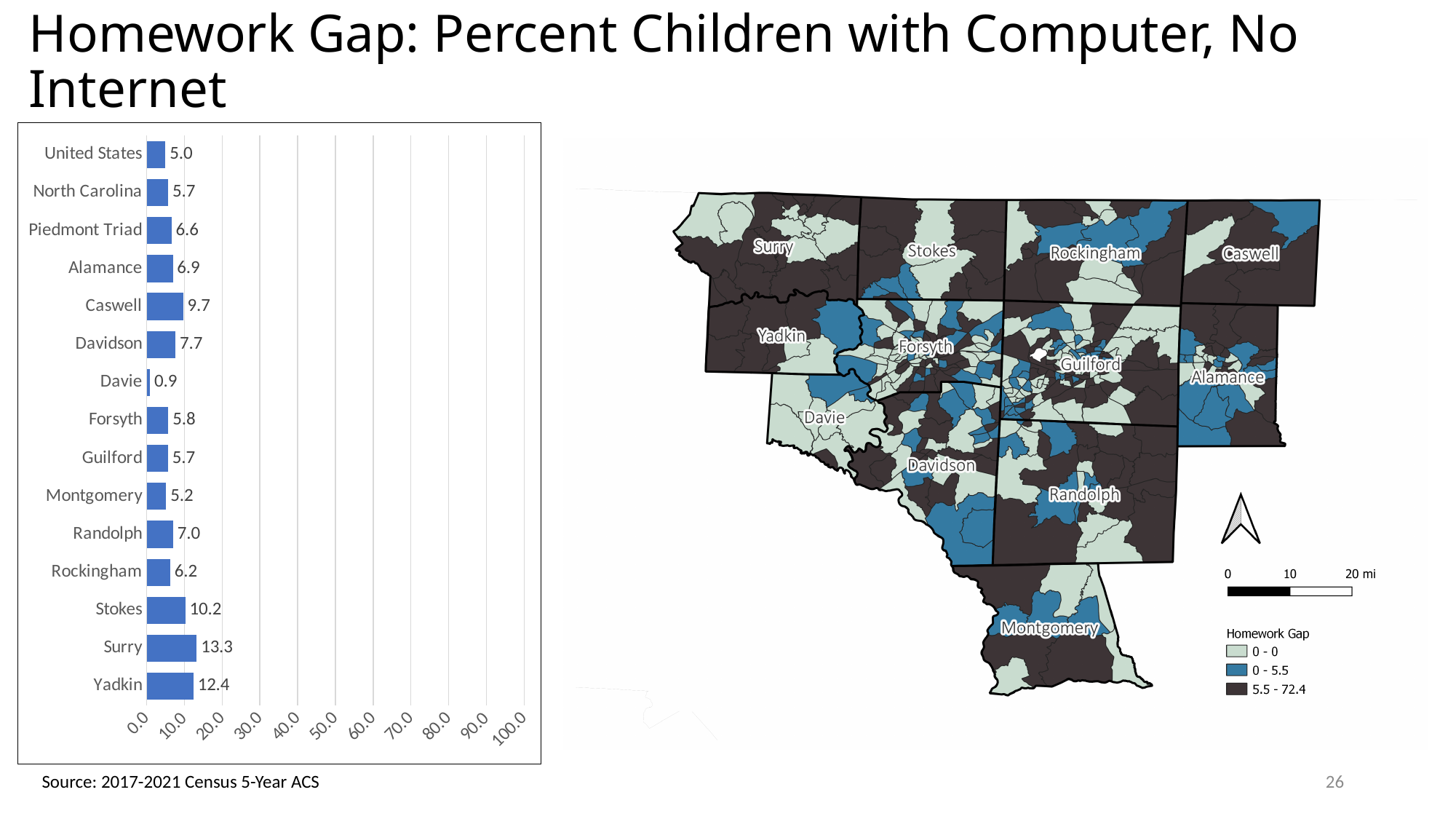
Which is larger in the bar chart, the value for Caswell or the value for Davidson? Caswell What is the difference between the values for North Carolina and the United States in the bar chart? 0.7 Which category has the lowest value in the bar chart? Davie What is the value for Surry in the bar chart? 13.3 What is the value for Piedmont Triad in the bar chart? 6.6 What is the highest value shown on the x axis of the bar chart? 100.0 What is the value for Davie in the bar chart? 0.9 What is the difference between the values for Yadkin and Stokes in the bar chart? 2.2 How many categories are shown in the bar chart? 15 What kind of chart is shown on the left of the slide? bar chart Is the value for Surry in the bar chart greater or less than 10.0? greater Which category has the highest value in the bar chart? Surry